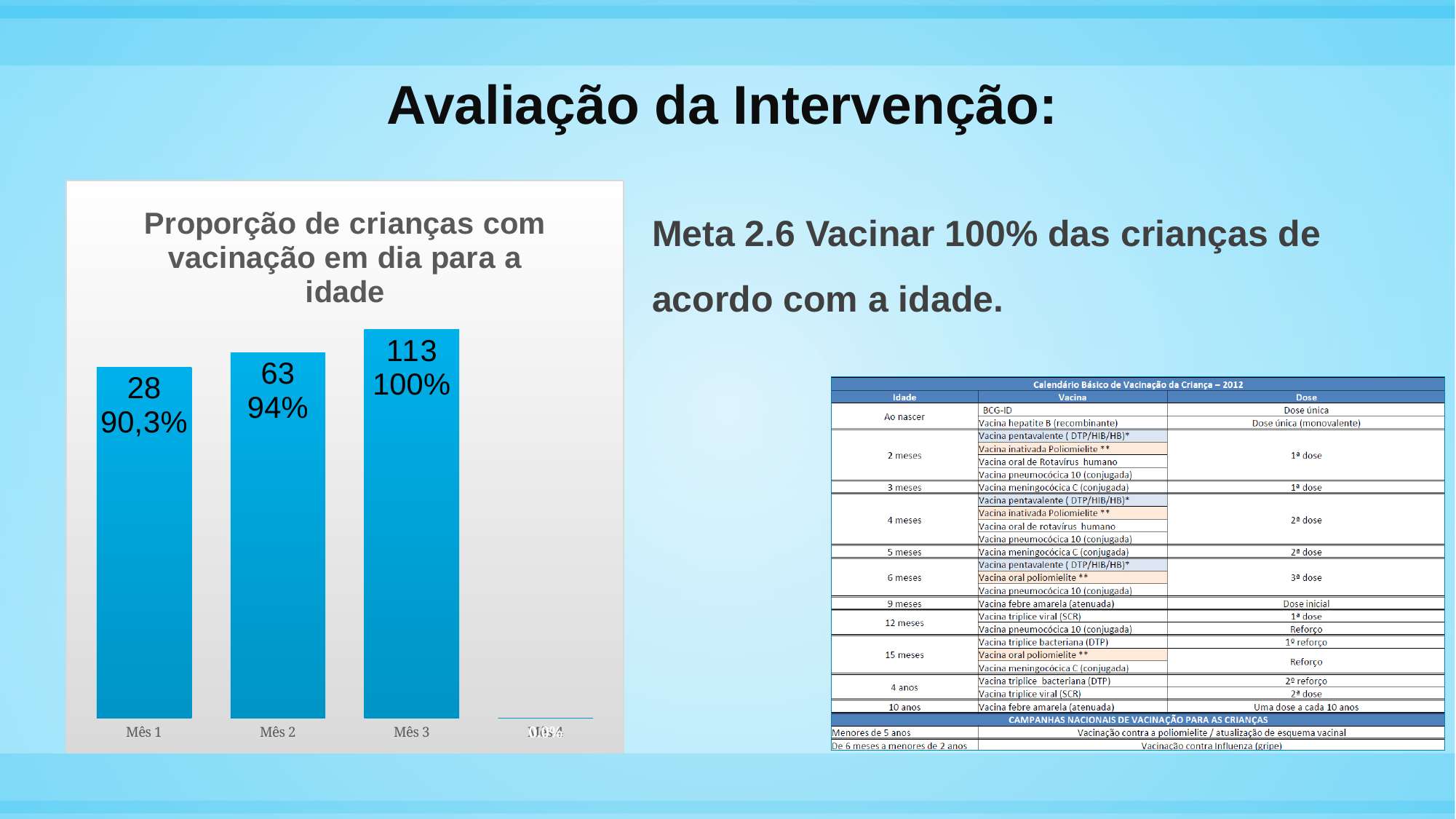
Which month has the highest bar? Mês 3 Which is larger, the value for Mês 2 or Mês 3? Mês 3 What is the title of the chart? Proporção de crianças com vacinação em dia para a idade What percentage is shown for Mês 3? 100% What kind of chart is shown on the slide? bar chart Do the values rise or fall from Mês 1 to Mês 3? rise What is the number of children shown for Mês 1? 28 What percentage is shown for Mês 1? 90,3% What is the number of children shown for Mês 2? 63 What is the difference between the number of children in Mês 3 and Mês 1? 85 What is the difference between the number of children in Mês 2 and Mês 1? 35